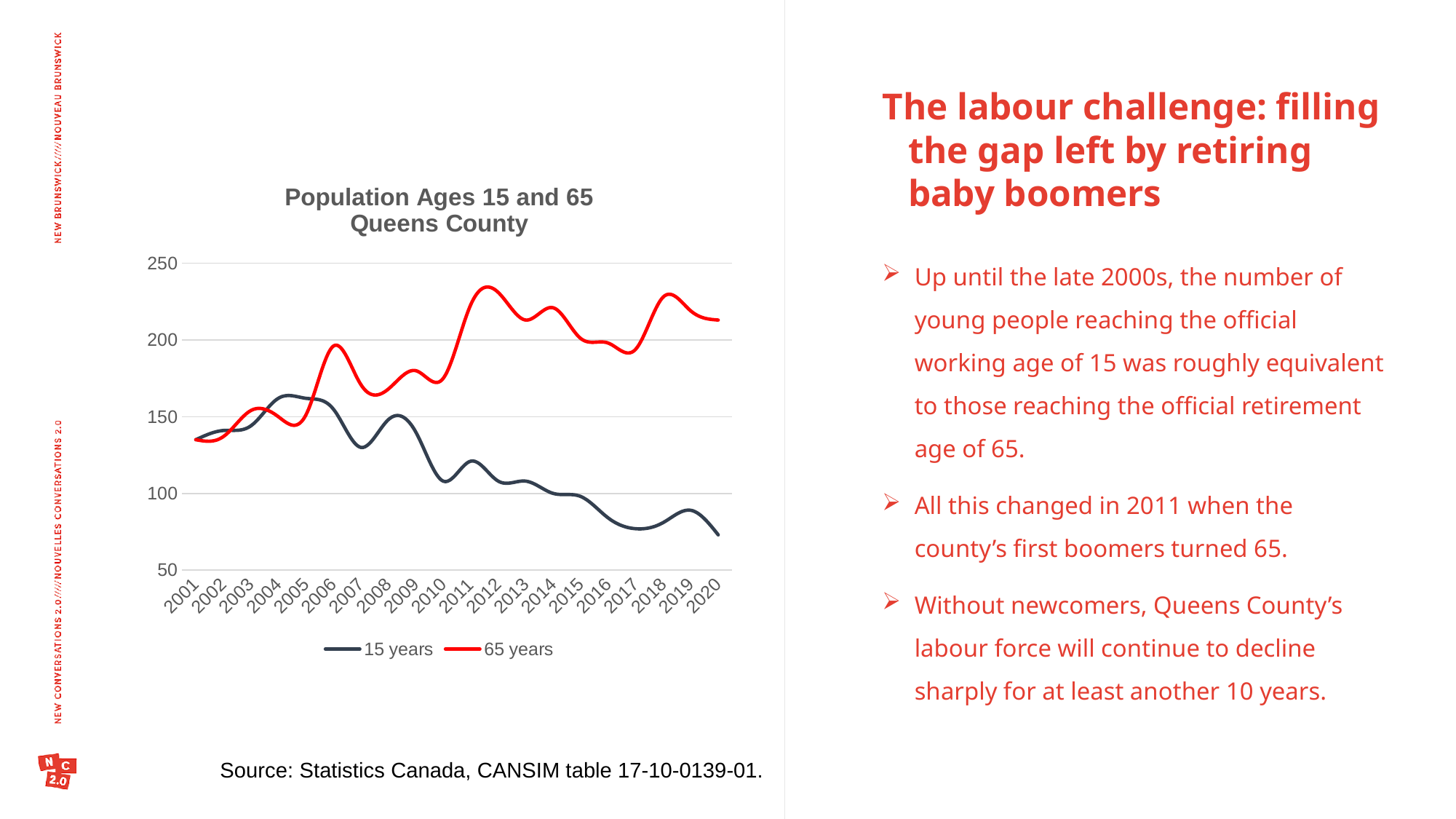
Overall, does the 15 years line rise or fall from 2005 to 2020? fall What is the title of the chart? Population Ages 15 and 65 Queens County How many years are shown along the x axis of the chart? 20 How many series does the legend of the chart list? 2 In 2005, which series has the larger value, 15 years or 65 years? 15 years What kind of chart is shown on the slide? line chart Overall, does the 65 years line rise or fall from 2001 to 2012? rise Is the value for 65 years in 2012 greater or less than 200? greater In 2020, which series has the larger value, 15 years or 65 years? 65 years Is the value for 15 years in 2008 greater or less than 100? greater Is the value for 15 years in 2020 greater or less than 100? less